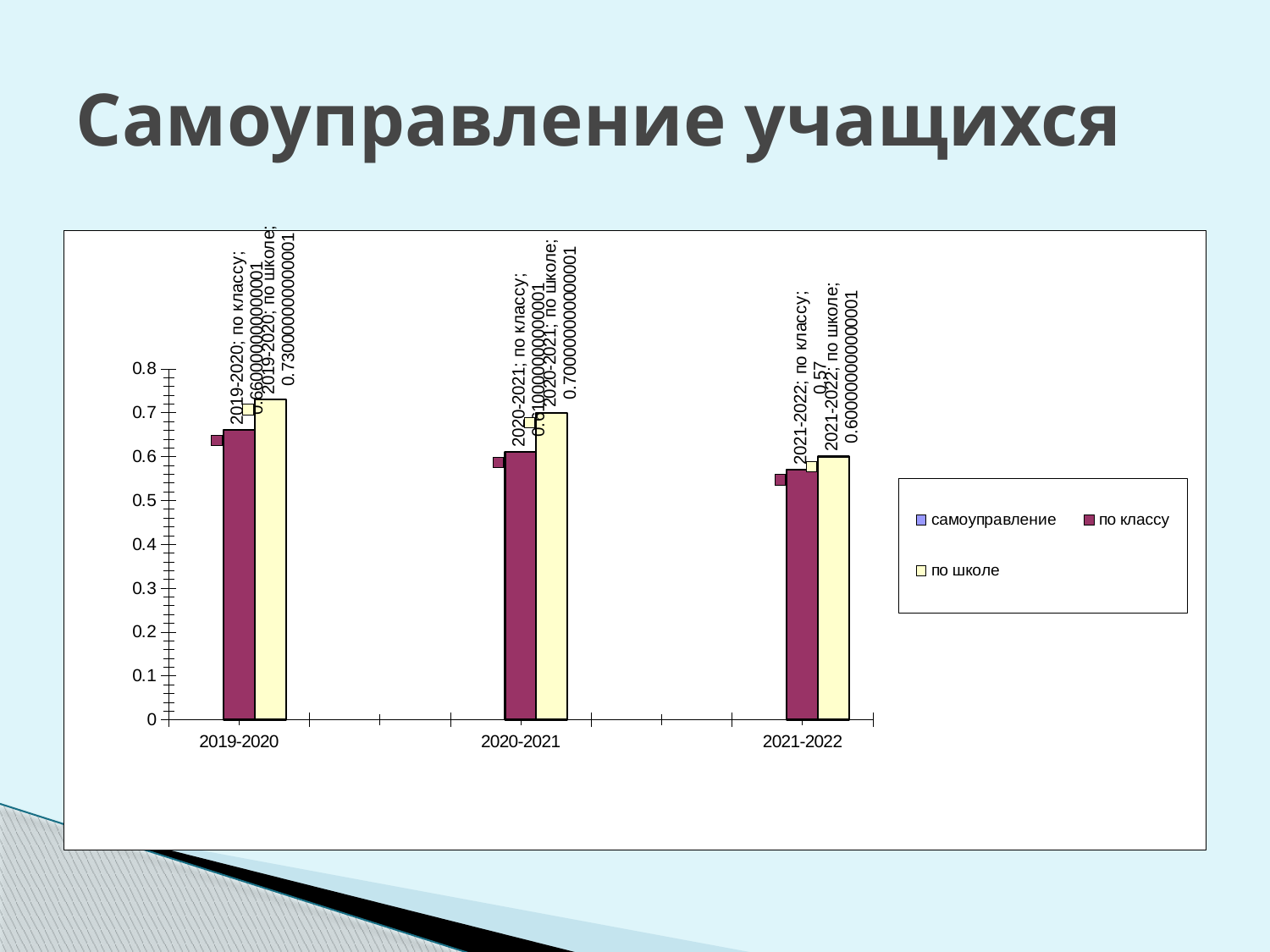
Do the 'по школе' values rise or fall from 2019-2020 to 2021-2022? fall In 2019-2020, which is larger: 'по классу' or 'по школе'? по школе Is the value for 'по классу' in 2020-2021 greater or less than 0.7? less What is the value for 'по школе' in 2019-2020? 0.730000000000001 What is the value for 'по классу' in 2021-2022? 0.57 What kind of chart is shown on the slide? bar chart What is the value for 'по школе' in 2021-2022? 0.600000000000001 How many series does the legend list? 3 Is the value for 'по классу' in 2019-2020 greater or less than 0.6? greater In which school year is the 'по школе' value highest? 2019-2020 How many school-year categories are shown on the x axis? 3 In which school year is the 'по школе' value lowest? 2021-2022